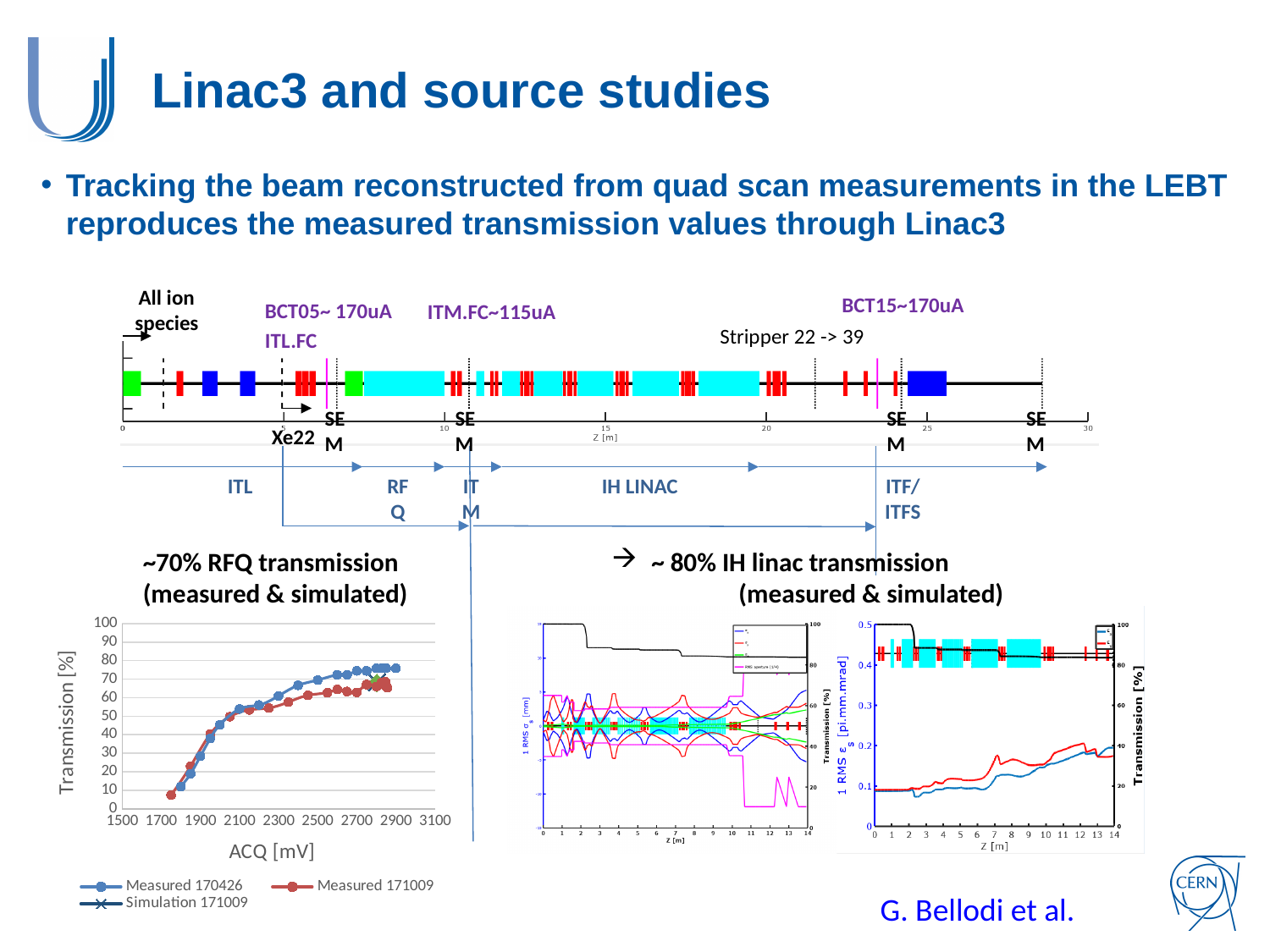
In the bottom-left Transmission chart, at ACQ 2700 mV, which series has the higher transmission, Measured 170426 or Measured 171009? Measured 170426 What kind of chart is the Transmission [%] vs ACQ [mV] chart at the bottom left of the slide? line chart In the bottom-left Transmission chart, is the lowest plotted transmission value (near ACQ 1750 mV) greater or less than 10? less In the bottom-left Transmission chart, is the Measured 170426 value at ACQ 2100 mV greater or less than 40? greater In the bottom-left Transmission chart, do the transmission values rise or fall as ACQ increases? rise In the bottom-left Transmission chart, is the Measured 170426 value at ACQ 2900 mV greater or less than 70? greater How many series does the legend of the bottom-left Transmission chart list? 3 What is the x-axis title of the bottom-left Transmission chart? ACQ [mV] What is the highest tick value shown on the y-axis of the bottom-left Transmission chart? 100 What are the legend entries of the bottom-left Transmission chart? Measured 170426, Measured 171009, Simulation 171009